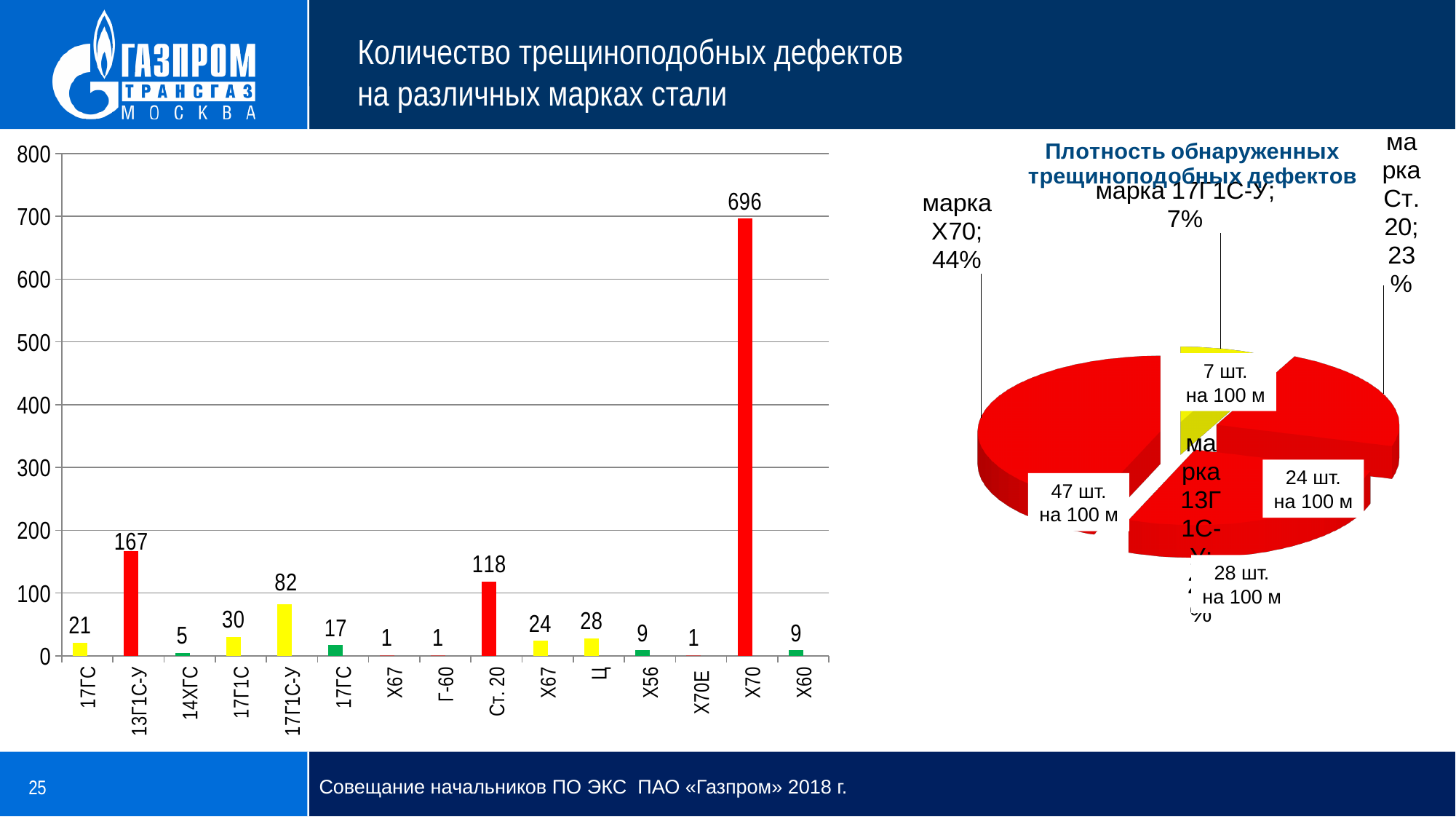
What is the title of the pie chart on the right? Плотность обнаруженных трещиноподобных дефектов In the bar chart on the left, what is the value for Ст. 20? 118 In the bar chart on the left, how many bars (categories) are plotted? 15 In the bar chart on the left, what is the difference between the values for Х70 and 13Г1С-У? 529 What kind of chart is shown on the left of the slide? Bar chart In the bar chart on the left, what is the value for 13Г1С-У? 167 In the pie chart on the right, what share does марка Ст. 20 have? 23% In the bar chart on the left, which category has the highest value? Х70 In the bar chart on the left, what is the value for Х70? 696 In the bar chart on the left, which is larger, the value for Ст. 20 or the value for 17Г1С-У? Ст. 20 In the bar chart on the left, what is the value for 17Г1С-У? 82 In the pie chart on the right, what share does марка Х70 have? 44%